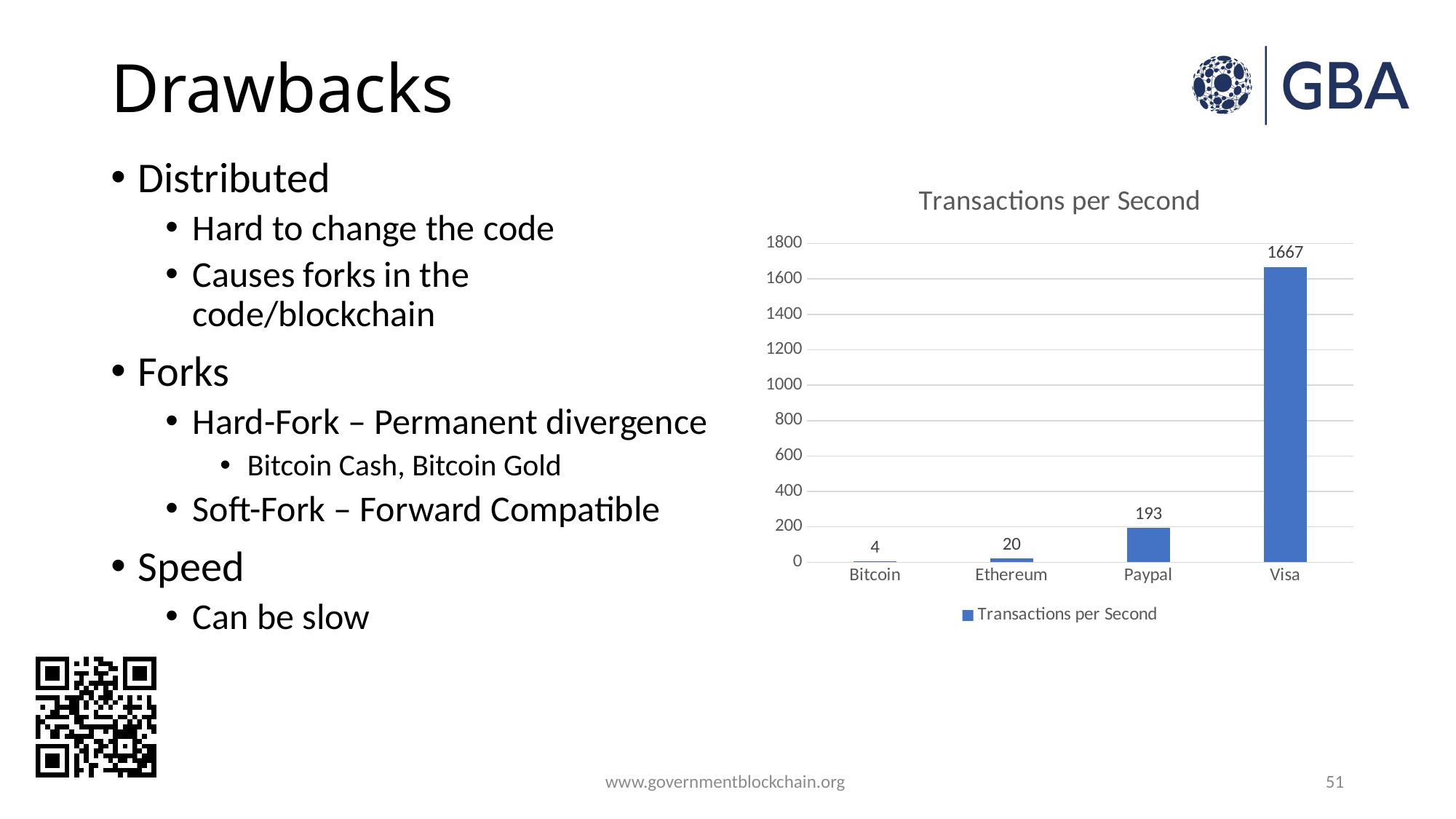
What is the value for Bitcoin in the Transactions per Second chart? 4 Which category has the highest value in the Transactions per Second chart? Visa What is the value for Ethereum in the Transactions per Second chart? 20 What is the title of the chart on the slide? Transactions per Second What is the difference between the values for Visa and Paypal in the Transactions per Second chart? 1474 What is the value for Paypal in the Transactions per Second chart? 193 Which category has the lowest value in the Transactions per Second chart? Bitcoin How many categories are shown in the Transactions per Second chart? 4 What is the value for Visa in the Transactions per Second chart? 1667 What is the difference between the values for Ethereum and Bitcoin in the Transactions per Second chart? 16 What kind of chart is the Transactions per Second chart? Bar chart Which is larger in the Transactions per Second chart, Paypal or Ethereum? Paypal